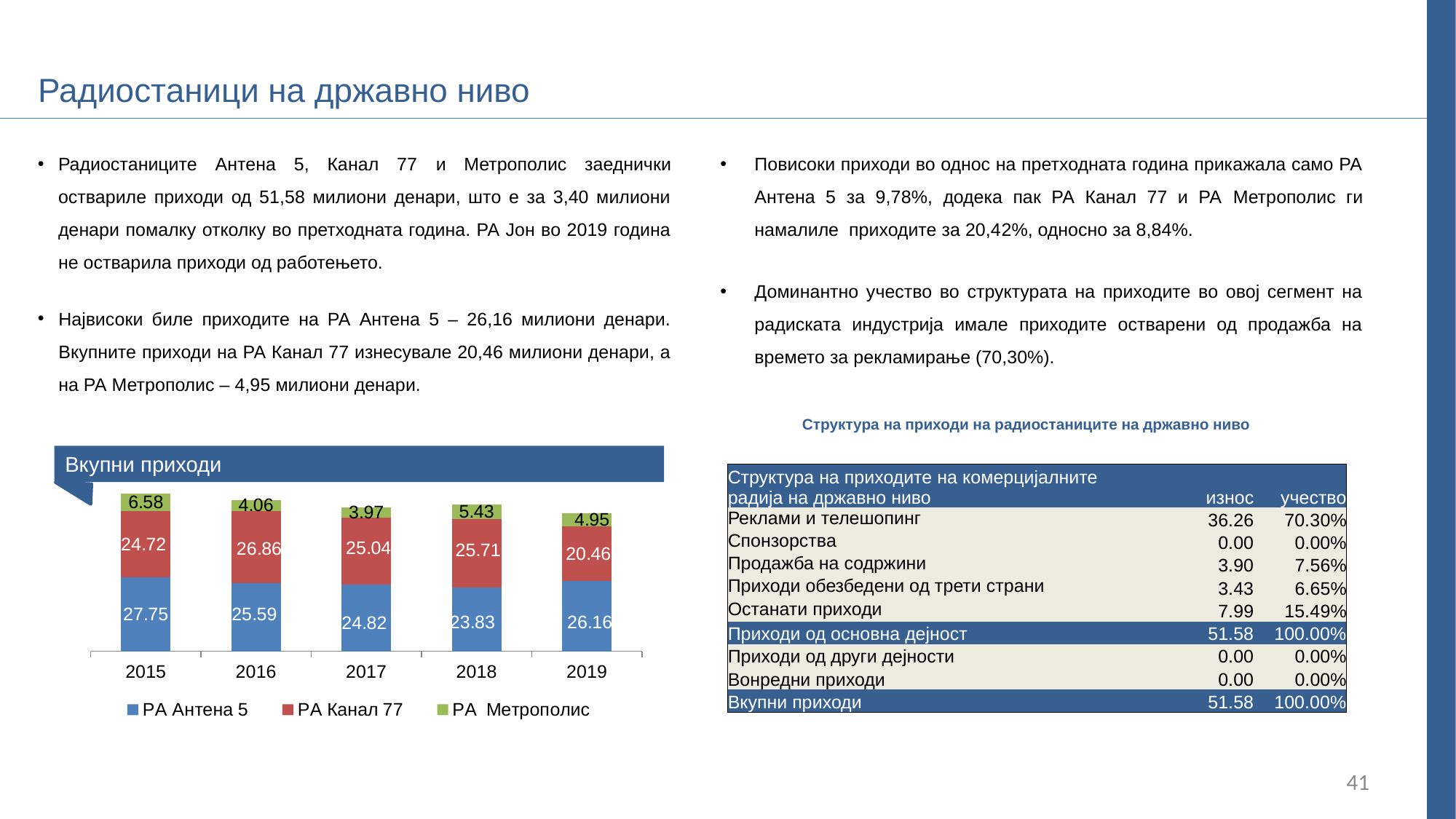
How many series does the legend list? 3 What is the difference between the РА Канал 77 values in 2016 and 2019? 6.40 What is the value for РА Антена 5 in 2015? 27.75 What is the value for РА Метрополис in 2018? 5.43 What is the title of the chart? Вкупни приходи In which year is the value for РА Антена 5 highest? 2015 What is the total of the stacked bar for 2015? 59.05 What kind of chart is shown? Stacked bar chart How many years are shown on the x axis? 5 What is the value for РА Канал 77 in 2019? 20.46 In which year is the value for РА Канал 77 lowest? 2019 In 2016, which is larger: the value for РА Антена 5 or for РА Канал 77? РА Канал 77